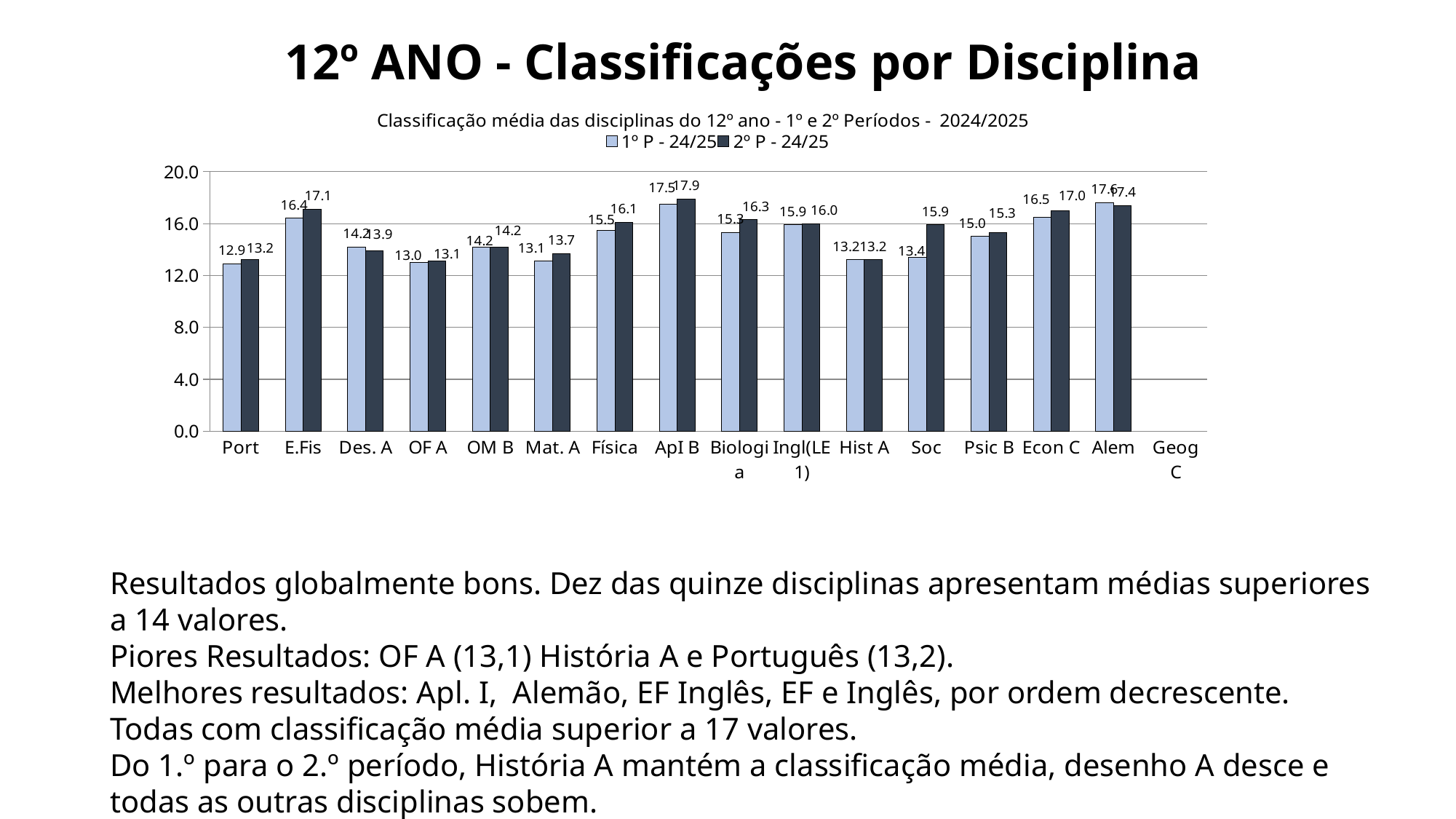
Which discipline has the highest value in the 2º P - 24/25 series? ApI B What is the value for Econ C in the 2º P - 24/25 series? 17.0 What kind of chart is shown on the slide? bar chart Which discipline has the lowest value in the 1º P - 24/25 series? Port What is the difference between the 2º P - 24/25 and 1º P - 24/25 values for Soc? 2.5 What is the value for Port in the 1º P - 24/25 series? 12.9 Which is larger for Alem: the 1º P - 24/25 value or the 2º P - 24/25 value? 1º P - 24/25 What is the title of the chart? Classificação média das disciplinas do 12º ano - 1º e 2º Períodos - 2024/2025 How many series does the legend list? 2 Is the 2º P - 24/25 value for Física greater or less than 16.0? greater What is the difference between the 1º P - 24/25 values for ApI B and Mat. A? 4.4 What is the value for Soc in the 2º P - 24/25 series? 15.9